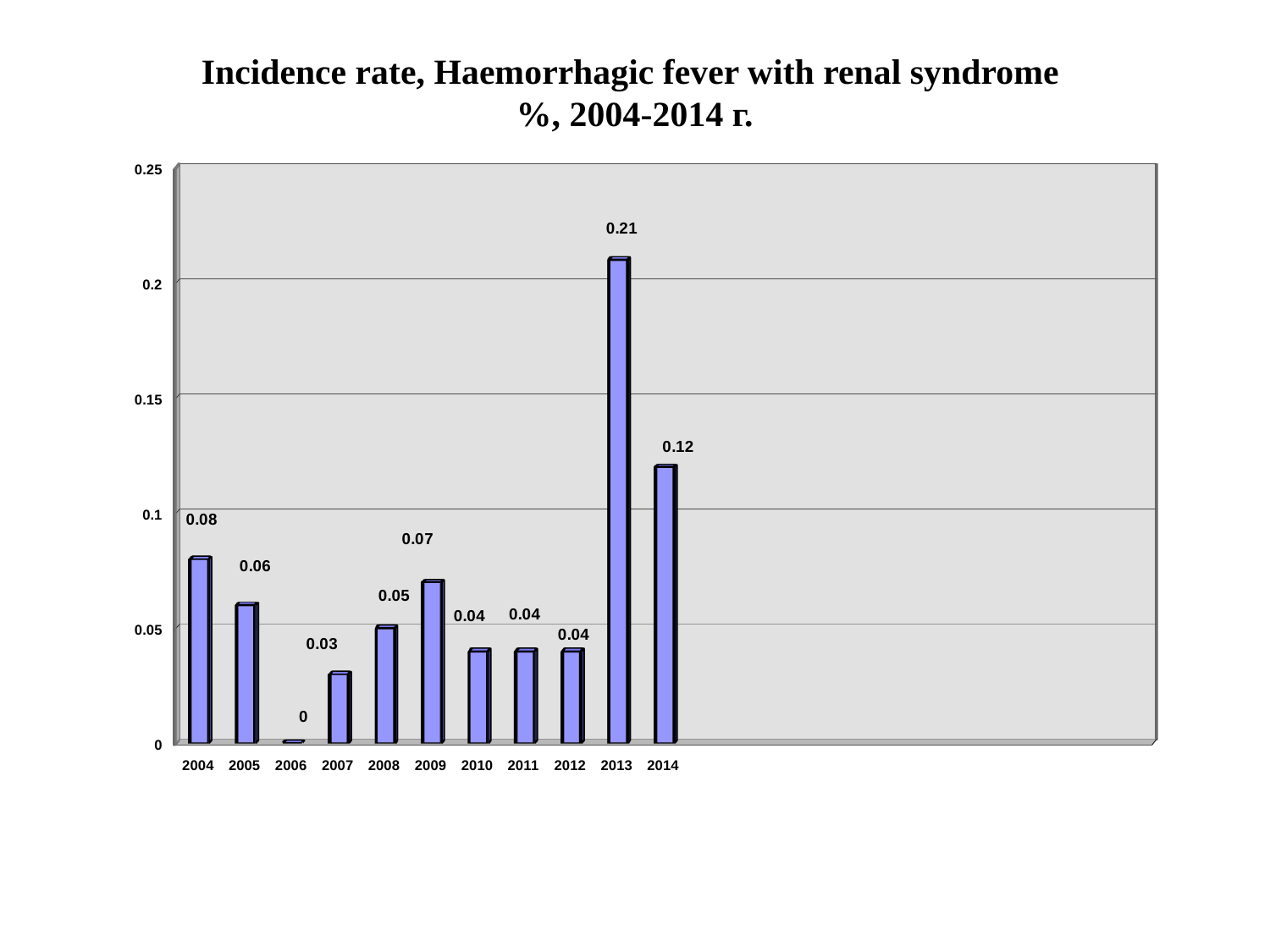
What is the difference between the incidence rates for 2013 and 2014? 0.09 Which year has the lowest incidence rate? 2006 What is the incidence rate for 2013? 0.21 How many years are shown on the x axis? 11 Is the value for 2013 greater or less than 0.2? greater Which year has a higher incidence rate, 2009 or 2005? 2009 Which year has the highest incidence rate? 2013 What is the incidence rate for 2014? 0.12 What kind of chart is shown on the slide? Bar chart What is the incidence rate for 2007? 0.03 What is the title of the chart? Incidence rate, Haemorrhagic fever with renal syndrome %, 2004-2014 г. What is the incidence rate for 2004? 0.08